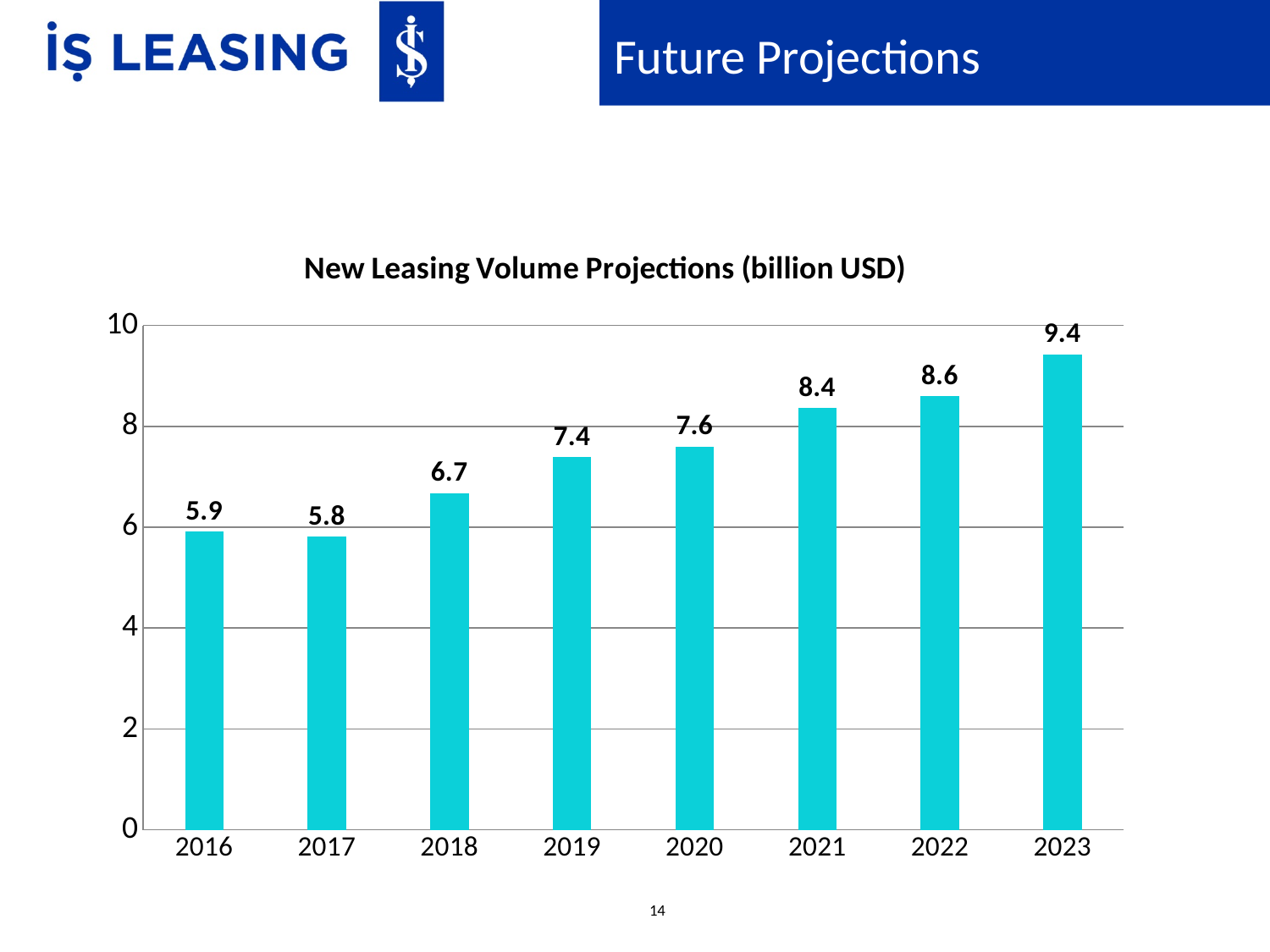
What is the difference between the values for 2021 and 2020? 0.8 Which year has the highest projected new leasing volume? 2023 What is the projected new leasing volume for 2023? 9.4 What is the value shown for 2016? 5.9 What is the projected new leasing volume for 2019? 7.4 Which year has a larger value, 2018 or 2022? 2022 Is the value for 2021 greater or less than 8? greater What is the difference between the values for 2023 and 2016? 3.5 What is the title of the chart? New Leasing Volume Projections (billion USD) Which year has the lowest projected new leasing volume? 2017 How many years are shown on the x axis of the chart? 8 What kind of chart is shown on the slide? Bar chart